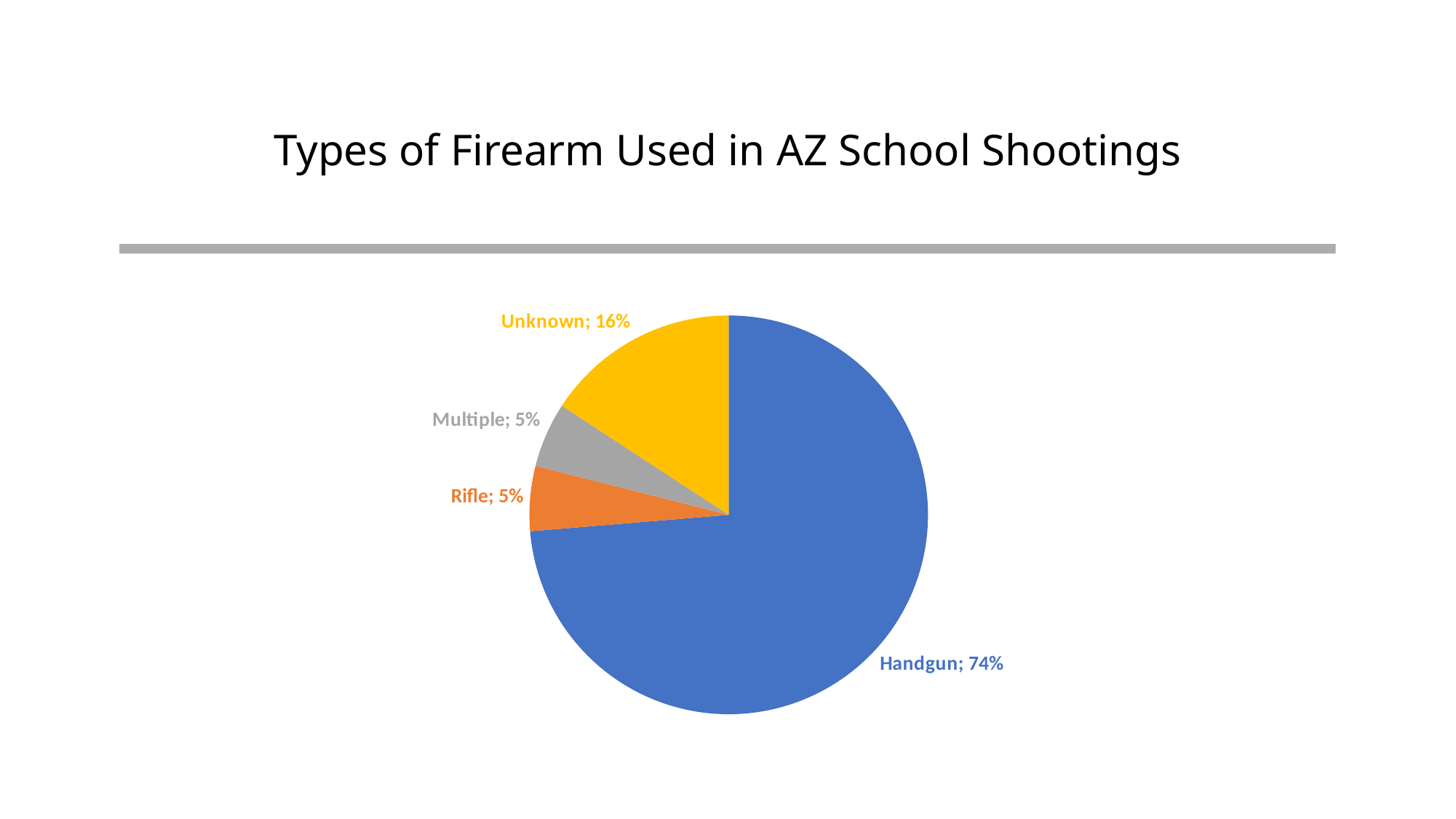
What is the value shown for Multiple? 5% What is the value shown for Unknown? 16% What share of the pie does Handgun represent? 74% What is the value shown for Rifle? 5% Which is larger, the share for Unknown or the share for Rifle? Unknown How many categories are shown in the pie chart? 4 What is the difference between the Handgun and Unknown shares? 58% What type of chart is shown on the slide? pie chart What is the difference between the Unknown and Multiple shares? 11% What colour is the Handgun slice? blue Which category has the largest slice of the pie? Handgun What is the title of the chart? Types of Firearm Used in AZ School Shootings